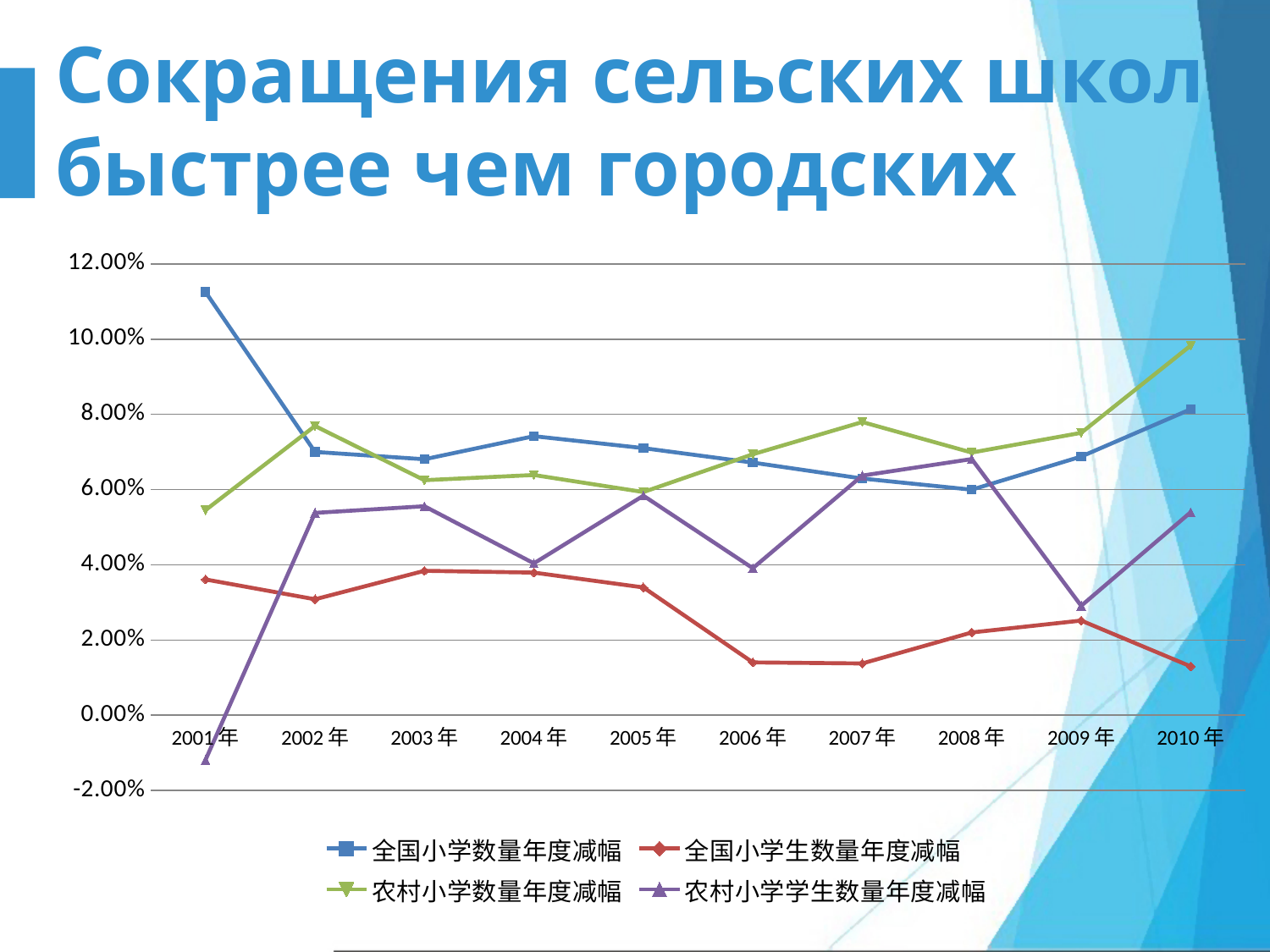
Is the value for 全国小学生数量年度减幅 in 2010年 greater or less than 2.00%? less In which year does 全国小学数量年度减幅 reach its highest value? 2001年 How many series does the legend list? 4 How many years are plotted along the x axis? 10 Is the value for 农村小学数量年度减幅 in 2010年 greater or less than 8.00%? greater Does 农村小学数量年度减幅 rise or fall from 2008年 to 2010年? rise In which year does 农村小学数量年度减幅 reach its highest value? 2010年 Is the value for 全国小学数量年度减幅 in 2001年 greater or less than 10.00%? greater In which year does 农村小学学生数量年度减幅 reach its lowest value? 2001年 In 2010年, which is larger: 农村小学数量年度减幅 or 全国小学数量年度减幅? 农村小学数量年度减幅 What kind of chart is shown on the slide? line chart